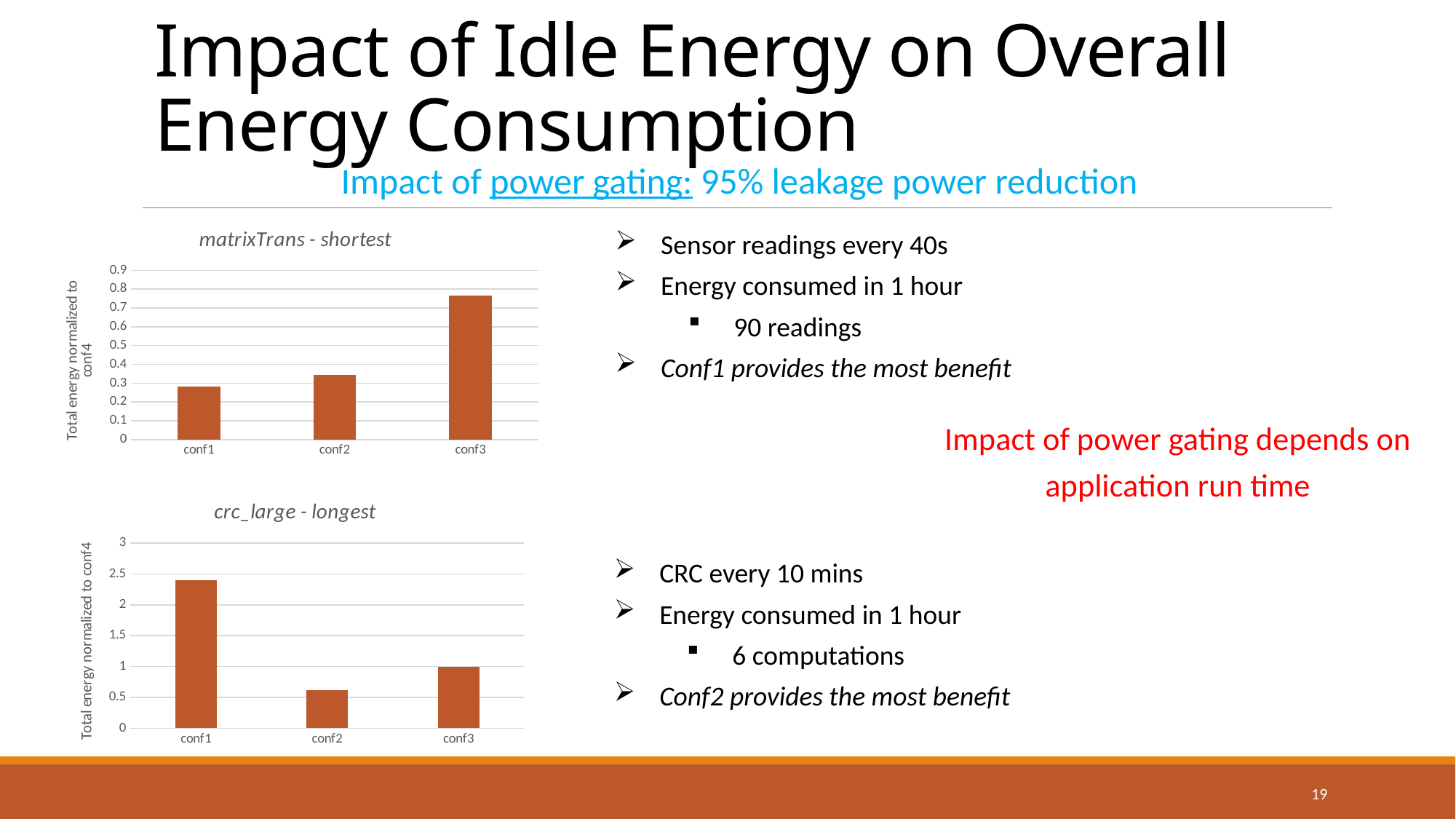
In the matrixTrans - shortest chart, is the value for conf3 greater or less than 0.7? greater In the matrixTrans - shortest chart, do the values rise or fall from conf1 to conf3? rise In the crc_large - longest chart, which configuration has the lowest total energy normalized to conf4? conf2 In the crc_large - longest chart, which configuration has the highest total energy normalized to conf4? conf1 In the matrixTrans - shortest chart, which configuration has the highest total energy normalized to conf4? conf3 In the crc_large - longest chart, is the value for conf2 greater or less than 1? less In the matrixTrans - shortest chart, which configuration has the lowest total energy normalized to conf4? conf1 What kind of chart is the matrixTrans - shortest chart? bar chart In the crc_large - longest chart, which is larger, the value for conf1 or the value for conf3? conf1 How many configurations are plotted in the crc_large - longest chart? 3 In the crc_large - longest chart, is the value for conf1 greater or less than 2? greater